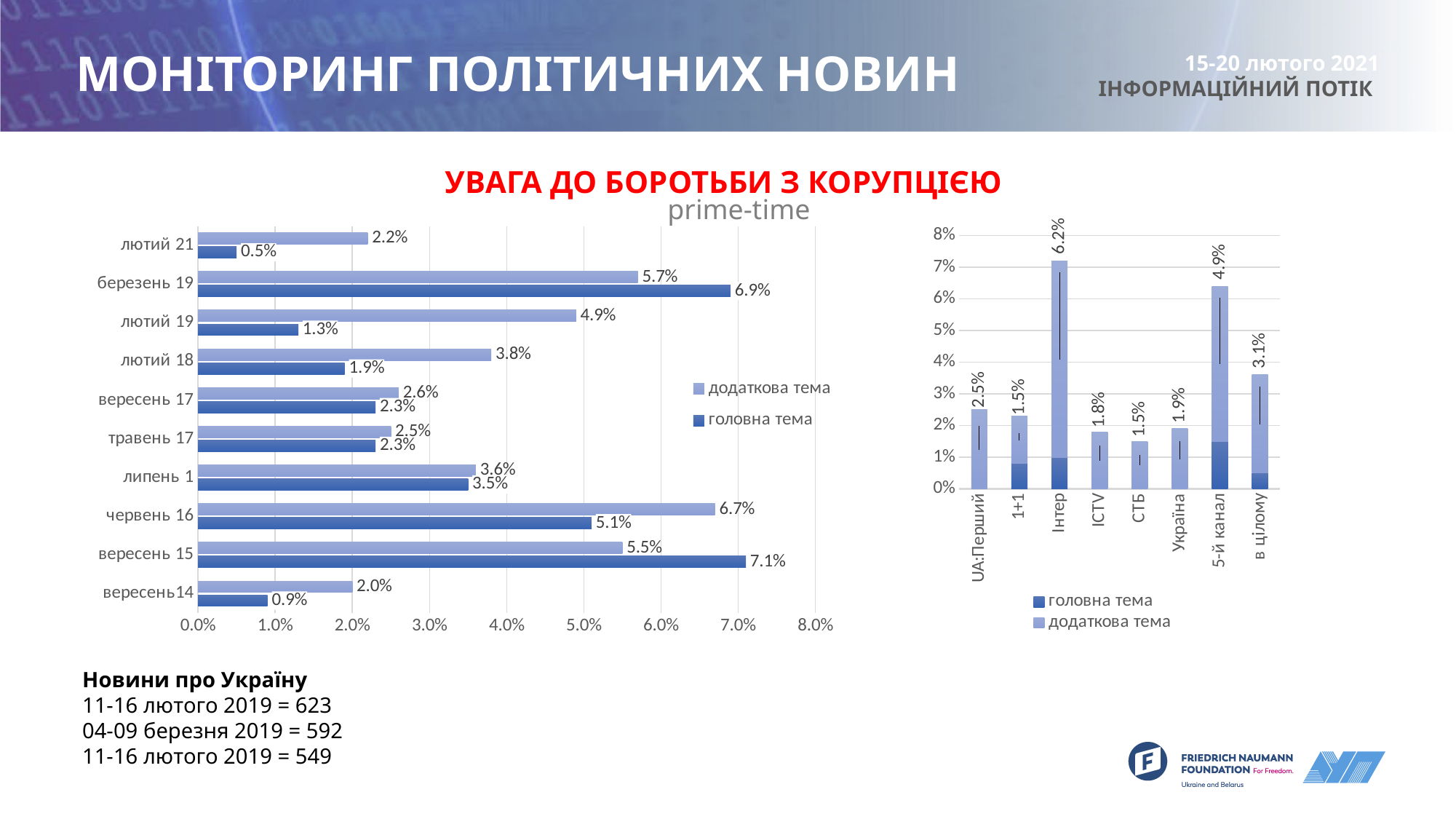
In the left 'prime-time' chart, what is the difference between 'головна тема' and 'додаткова тема' for 'березень 19'? 1.2% In the right chart by channel, is the total stacked bar for 'СТБ' greater or less than 2%? less In the right chart by channel, is the total stacked bar for 'Інтер' greater or less than 6%? greater What kind of chart is the left 'prime-time' chart? bar chart In the left 'prime-time' chart, what is the value of 'додаткова тема' for 'лютий 21'? 2.2% How many series does the legend of the left 'prime-time' chart list? 2 In the left 'prime-time' chart, which is larger for 'червень 16': 'додаткова тема' or 'головна тема'? додаткова тема How many periods (categories) are shown in the left 'prime-time' chart? 10 In the left 'prime-time' chart, which period has the lowest value for 'головна тема'? лютий 21 In the left 'prime-time' chart, what is the value of 'головна тема' for 'березень 19'? 6.9% How many channel categories are shown on the x axis of the right chart? 8 In the left 'prime-time' chart, which period has the highest value for 'головна тема'? вересень 15